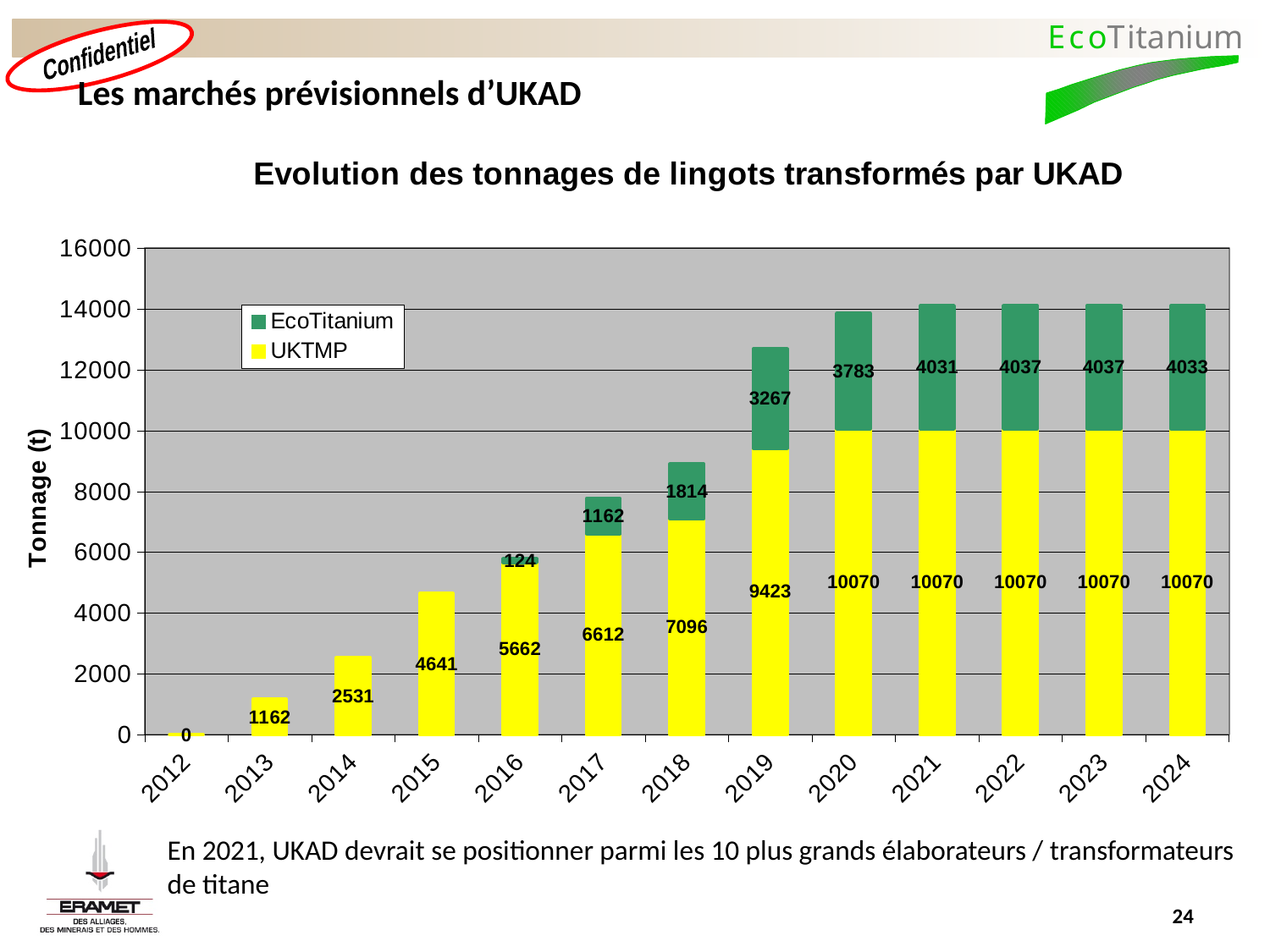
What is the UKTMP value for 2018? 7096 What type of chart is shown on the slide? stacked bar chart What is the title of the chart? Evolution des tonnages de lingots transformés par UKAD Do the UKTMP values rise or fall from 2012 to 2020? rise How many series does the legend list? 2 What is the UKTMP value for 2015? 4641 What is the difference between the UKTMP values for 2014 and 2013? 1369 Which is larger, the EcoTitanium value for 2020 or for 2018? 2020 How many years are shown on the x axis? 13 In which year is the EcoTitanium value the lowest among the years where it is labelled? 2016 What is the EcoTitanium value for 2019? 3267 What is the total of the stacked bar for 2021? 14101